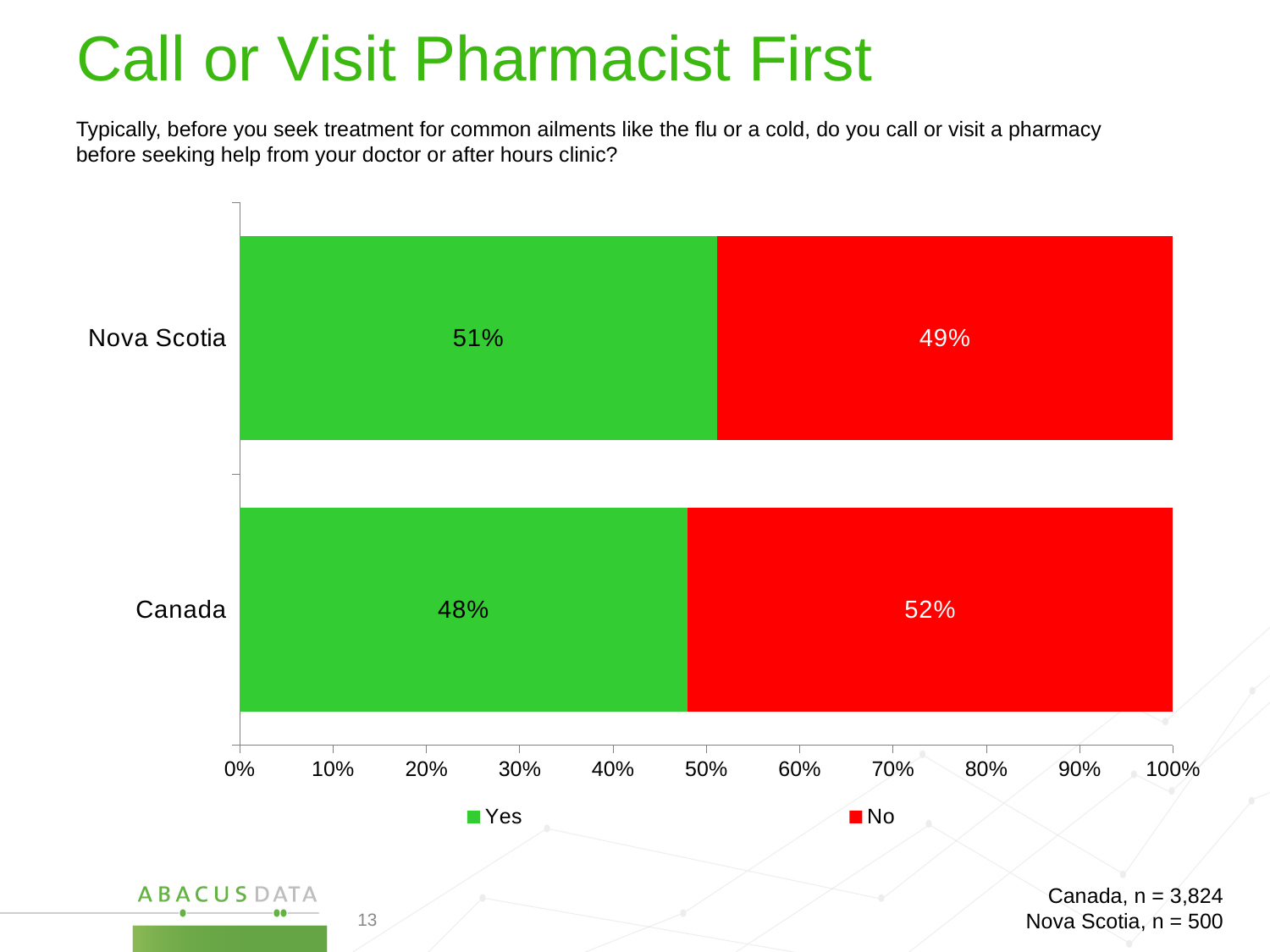
What percentage of Nova Scotia respondents answered No? 49% Which category has the higher Yes percentage, Nova Scotia or Canada? Nova Scotia What percentage of Nova Scotia respondents answered Yes? 51% Which category has the higher No percentage, Nova Scotia or Canada? Canada What is the total of the Yes and No segments for the Nova Scotia bar? 100% How many categories are shown on the chart? 2 How many series does the legend list? 2 What percentage of Canada respondents answered Yes? 48% What is the difference between the Yes percentages for Nova Scotia and Canada? 3% What percentage of Canada respondents answered No? 52% What is the difference between the Yes and No percentages for Canada? 4% What kind of chart is shown on the slide? Stacked bar chart